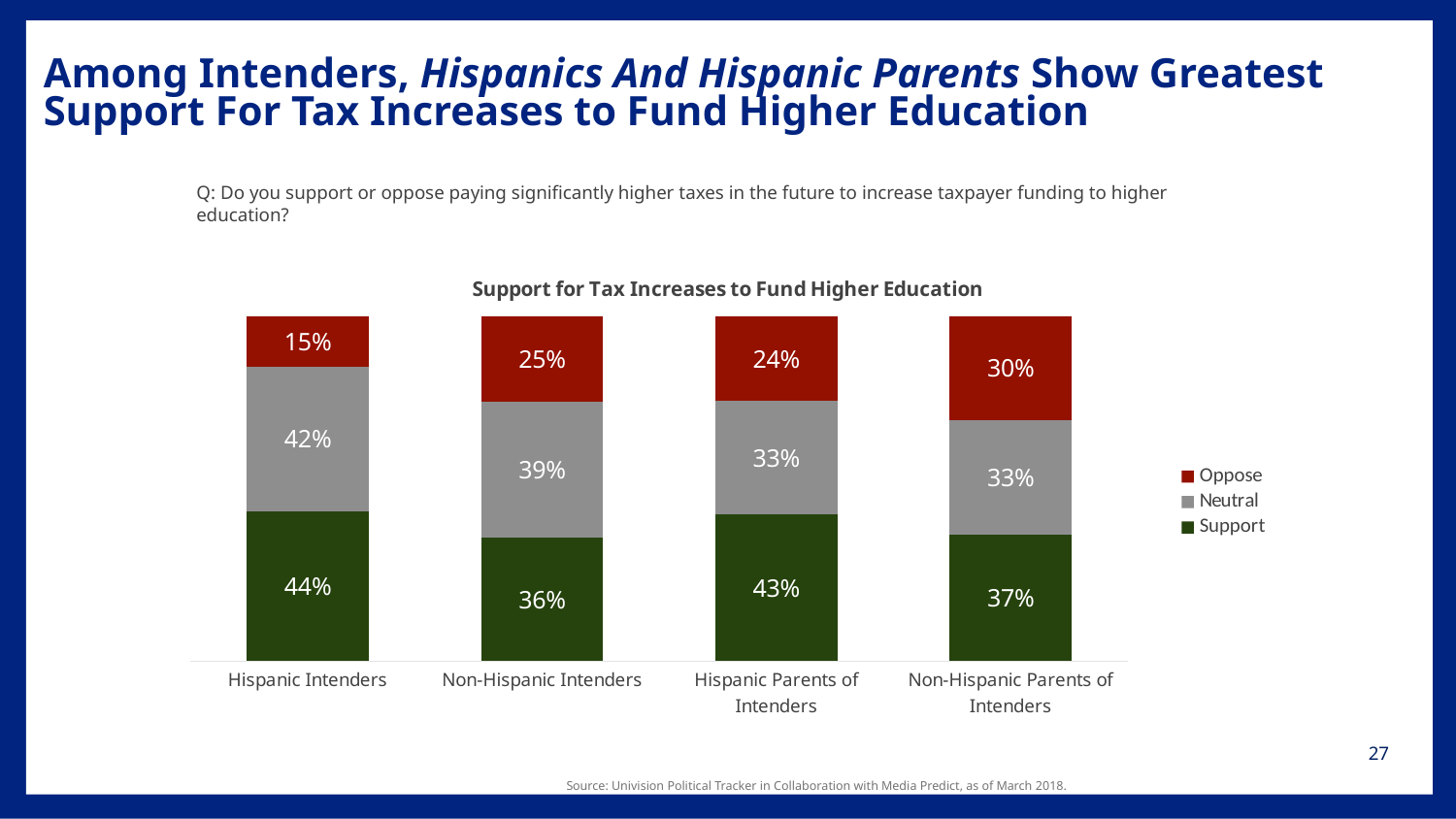
Which is larger: the Oppose value for Non-Hispanic Intenders or the Oppose value for Hispanic Parents of Intenders? Non-Hispanic Intenders What is the difference between the Support values for Hispanic Intenders and Non-Hispanic Intenders? 8 percentage points How many groups are shown on the x axis of the chart? 4 What is the total of the stacked bar for Hispanic Parents of Intenders? 100% What percentage of Non-Hispanic Parents of Intenders oppose tax increases to fund higher education? 30% What is the Neutral value for Non-Hispanic Intenders? 39% What is the title of the chart? Support for Tax Increases to Fund Higher Education Which group has the highest Support value? Hispanic Intenders What kind of chart is shown on the slide? Stacked bar chart What percentage of Hispanic Intenders support tax increases to fund higher education? 44% Which group has the lowest Oppose value? Hispanic Intenders How many series does the legend list? 3